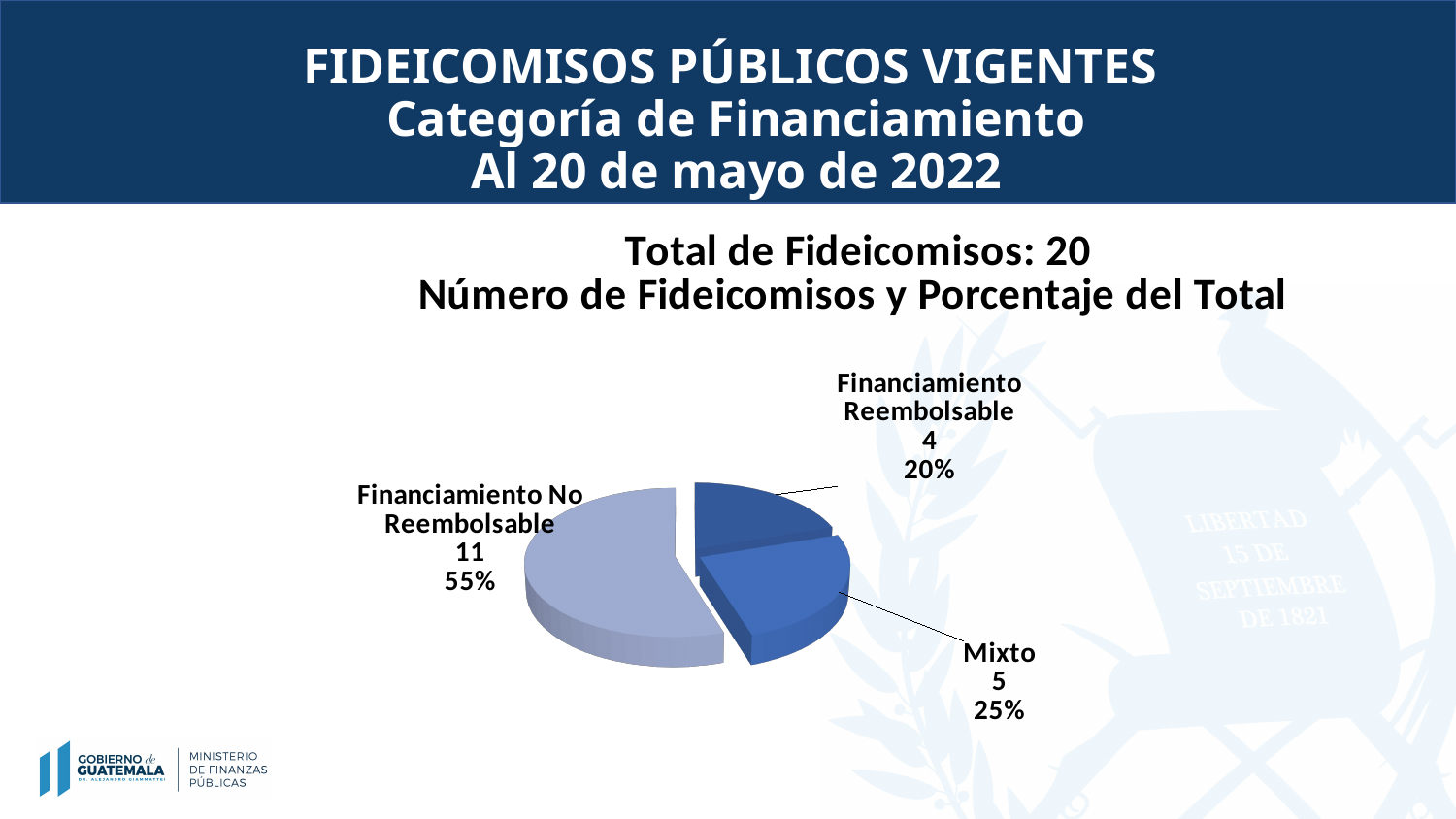
How many fideicomisos are in the Mixto category? 5 Which category has the smallest number of fideicomisos? Financiamiento Reembolsable Which category has the largest number of fideicomisos? Financiamiento No Reembolsable What is the total number of fideicomisos stated on the slide? 20 What is the difference in the number of fideicomisos between Financiamiento No Reembolsable and Mixto? 6 What share of the pie does Financiamiento No Reembolsable represent? 55% What kind of chart is shown on the slide? Pie chart What percentage of the total does Financiamiento Reembolsable represent? 20% Which has more fideicomisos, Mixto or Financiamiento Reembolsable? Mixto How many categories are shown in the pie chart? 3 How many fideicomisos are in the Financiamiento No Reembolsable category? 11 What is the percentage share of the Mixto category? 25%